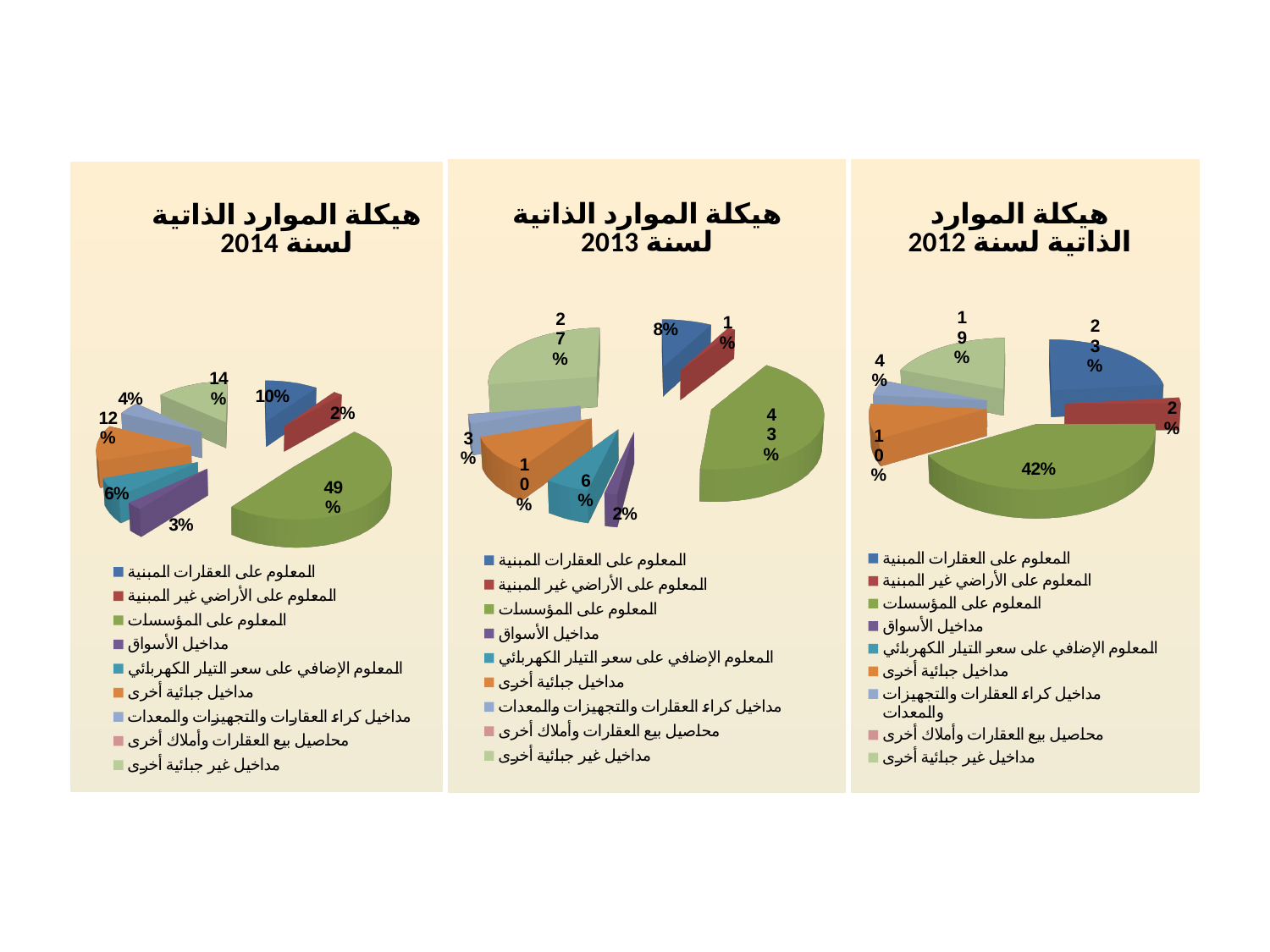
In the 2013 chart, what share does مداخيل غير جبائية أخرى (light green slice) have? 27% In the 2012 chart (هيكلة الموارد الذاتية لسنة 2012), what share does المعلوم على المؤسسات (green slice) have? 42% In the 2012 chart, what is the difference between the share of المعلوم على المؤسسات and the share of المعلوم على العقارات المبنية? 19% How many pie charts are shown on the slide? 3 What kind of chart is used on this slide? Pie chart How many entries does the legend of the 2014 chart list? 9 In the 2013 chart (هيكلة الموارد الذاتية لسنة 2013), what share does المعلوم على العقارات المبنية (blue slice) have? 8% In the 2013 chart, which category has the smallest labelled share? المعلوم على الأراضي غير المبنية In the 2014 chart, which category has the largest share? المعلوم على المؤسسات In the 2014 chart, what share does مداخيل جبائية أخرى (orange slice) have? 12% In the 2014 chart (هيكلة الموارد الذاتية لسنة 2014), what share does مداخيل غير جبائية أخرى (light green slice) have? 14% In the 2013 chart, which is larger: the share of مداخيل جبائية أخرى (orange) or the share of المعلوم الإضافي على سعر التيار الكهربائي (teal)? مداخيل جبائية أخرى